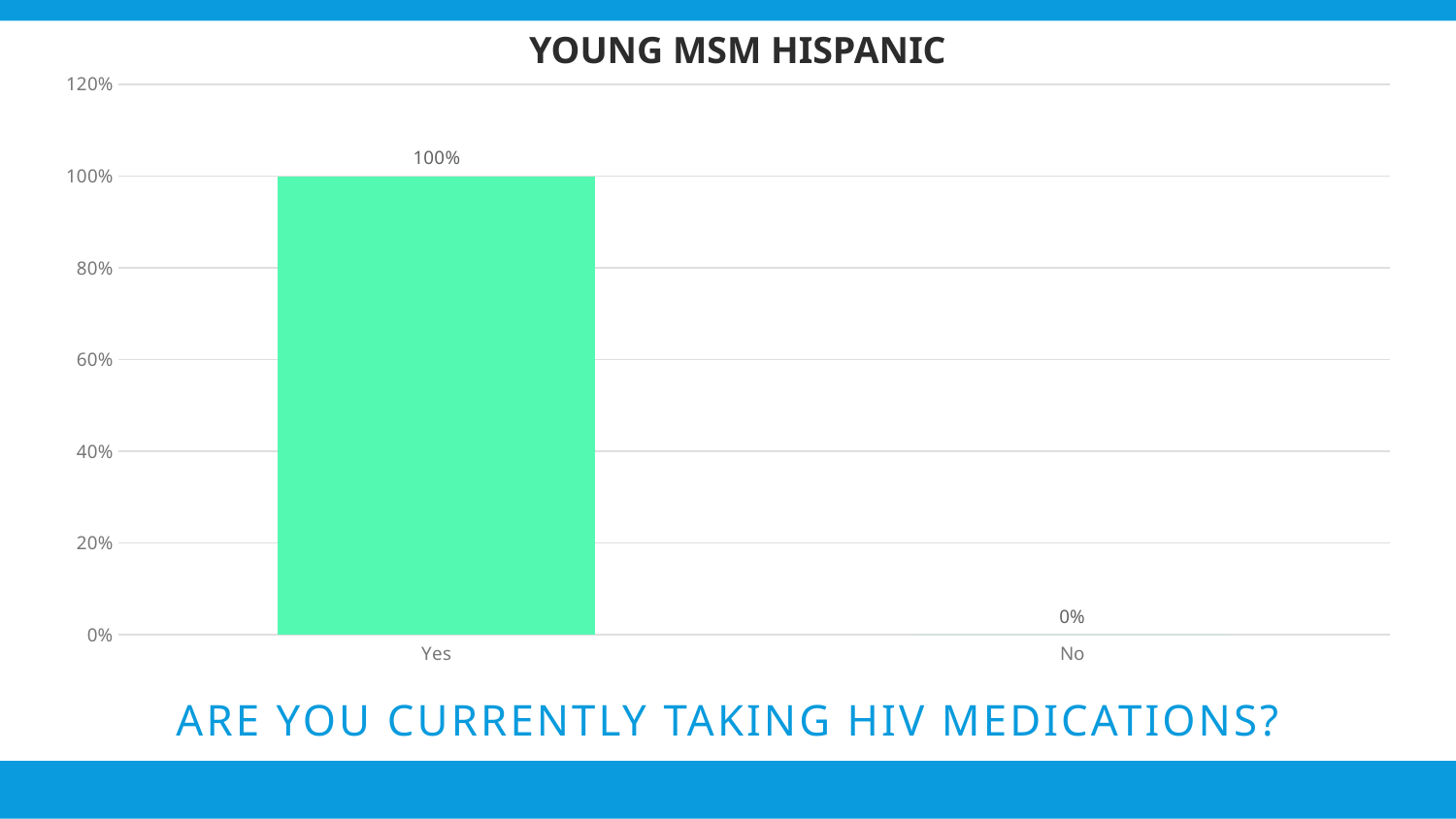
What is the title of the chart? YOUNG MSM HISPANIC Which is larger, the value for Yes or the value for No? Yes What is the difference between the values for Yes and No? 100% What is the value for No? 0% How many categories are shown on the x axis? 2 What is the value for Yes? 100% What is the highest value shown on the y axis? 120% Which category has the highest value? Yes What kind of chart is shown on the slide? bar chart Is the value for Yes greater or less than 80%? greater Which category has the lowest value? No